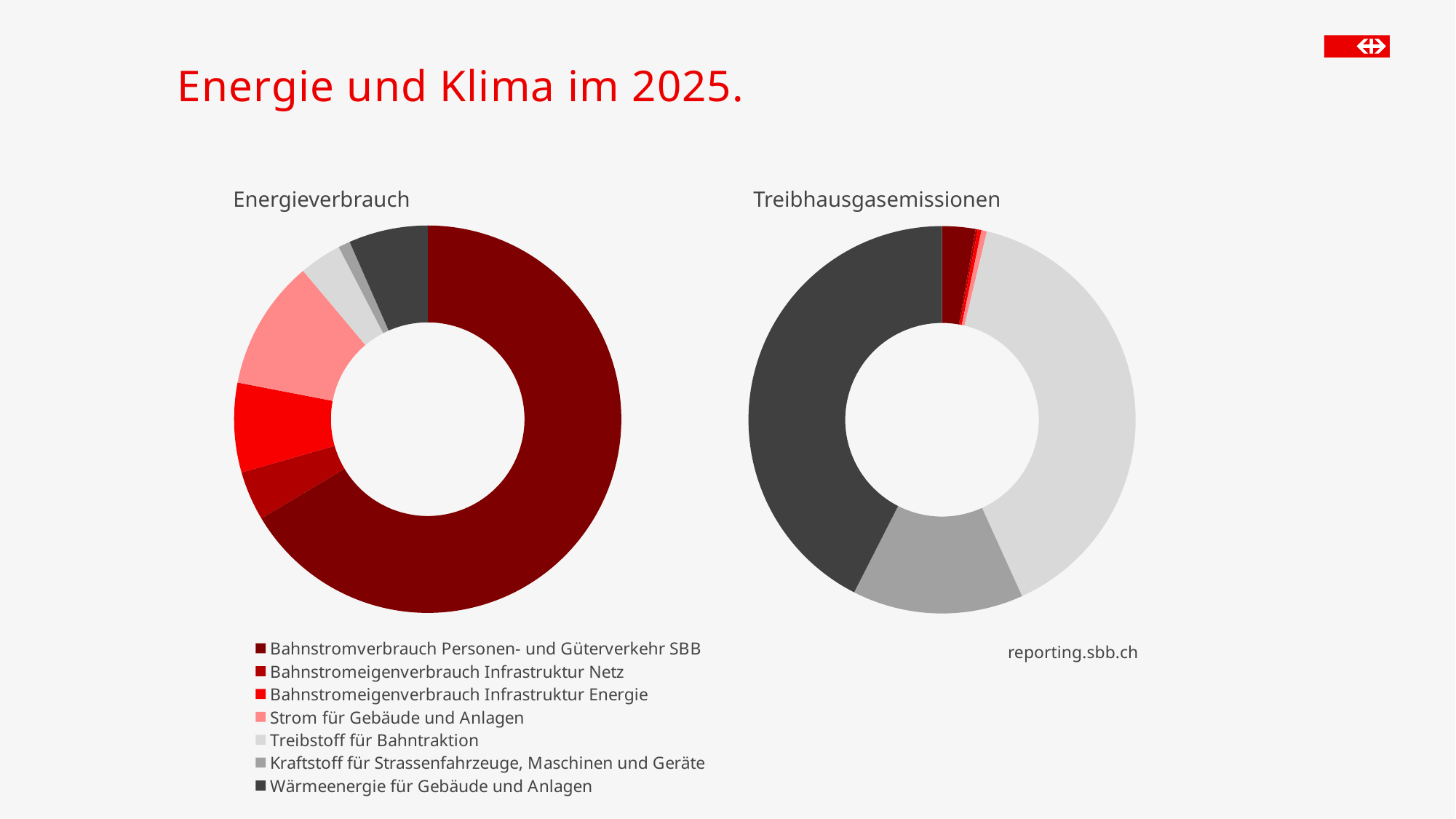
How many charts are shown on the slide? 2 What is the title of the slide? Energie und Klima im 2025. What kind of chart is the Energieverbrauch chart? Donut (pie) chart In the Treibhausgasemissionen chart, which is larger: Wärmeenergie für Gebäude und Anlagen or Kraftstoff für Strassenfahrzeuge, Maschinen und Geräte? Wärmeenergie für Gebäude und Anlagen In the Energieverbrauch chart, which is larger: Strom für Gebäude und Anlagen or Bahnstromeigenverbrauch Infrastruktur Netz? Strom für Gebäude und Anlagen In the Treibhausgasemissionen chart, which is larger: Treibstoff für Bahntraktion or Bahnstromverbrauch Personen- und Güterverkehr SBB? Treibstoff für Bahntraktion How many categories does the legend list? 7 In the Energieverbrauch chart, which category has the smallest share? Kraftstoff für Strassenfahrzeuge, Maschinen und Geräte In the Energieverbrauch chart, which category has the largest share? Bahnstromverbrauch Personen- und Güterverkehr SBB In the Energieverbrauch chart, is the share of Bahnstromverbrauch Personen- und Güterverkehr SBB greater or less than half of the total? greater What source is cited below the Treibhausgasemissionen chart? reporting.sbb.ch